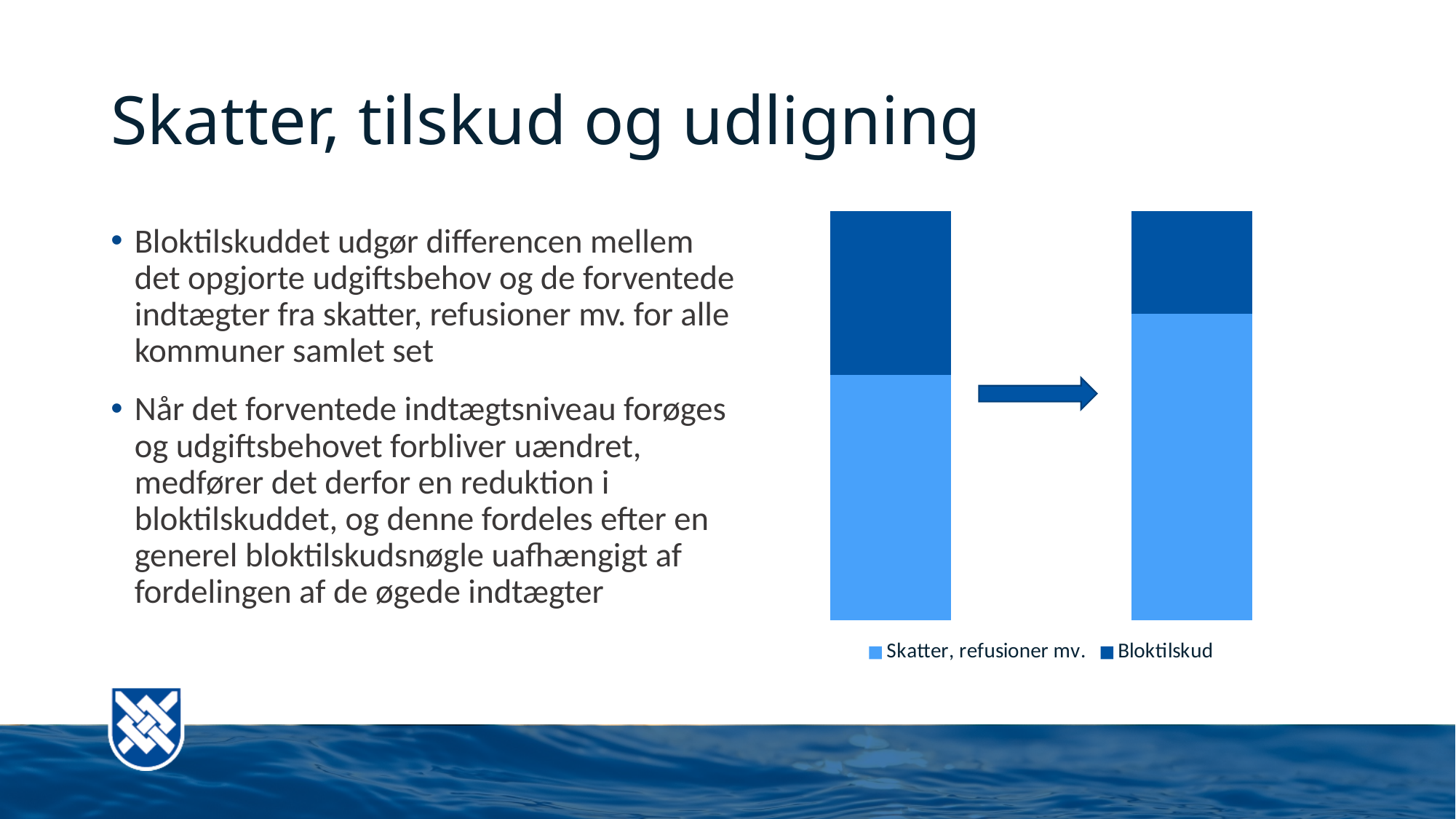
In the right bar, which segment is larger: Skatter, refusioner mv. or Bloktilskud? Skatter, refusioner mv. Is the Skatter, refusioner mv. segment larger in the left bar or the right bar? Right bar Does the Skatter, refusioner mv. segment rise or fall from the left bar to the right bar? Rise In the left bar, which segment is larger: Skatter, refusioner mv. or Bloktilskud? Skatter, refusioner mv. Which series is shown in dark blue in the chart? Bloktilskud What kind of chart is shown on the right side of the slide? Stacked bar chart How many series does the chart's legend list? 2 Which series is shown in light blue in the chart? Skatter, refusioner mv. How many bars are plotted in the chart? 2 Which bar has the larger Bloktilskud segment? Left bar Does the Bloktilskud segment rise or fall from the left bar to the right bar? Fall